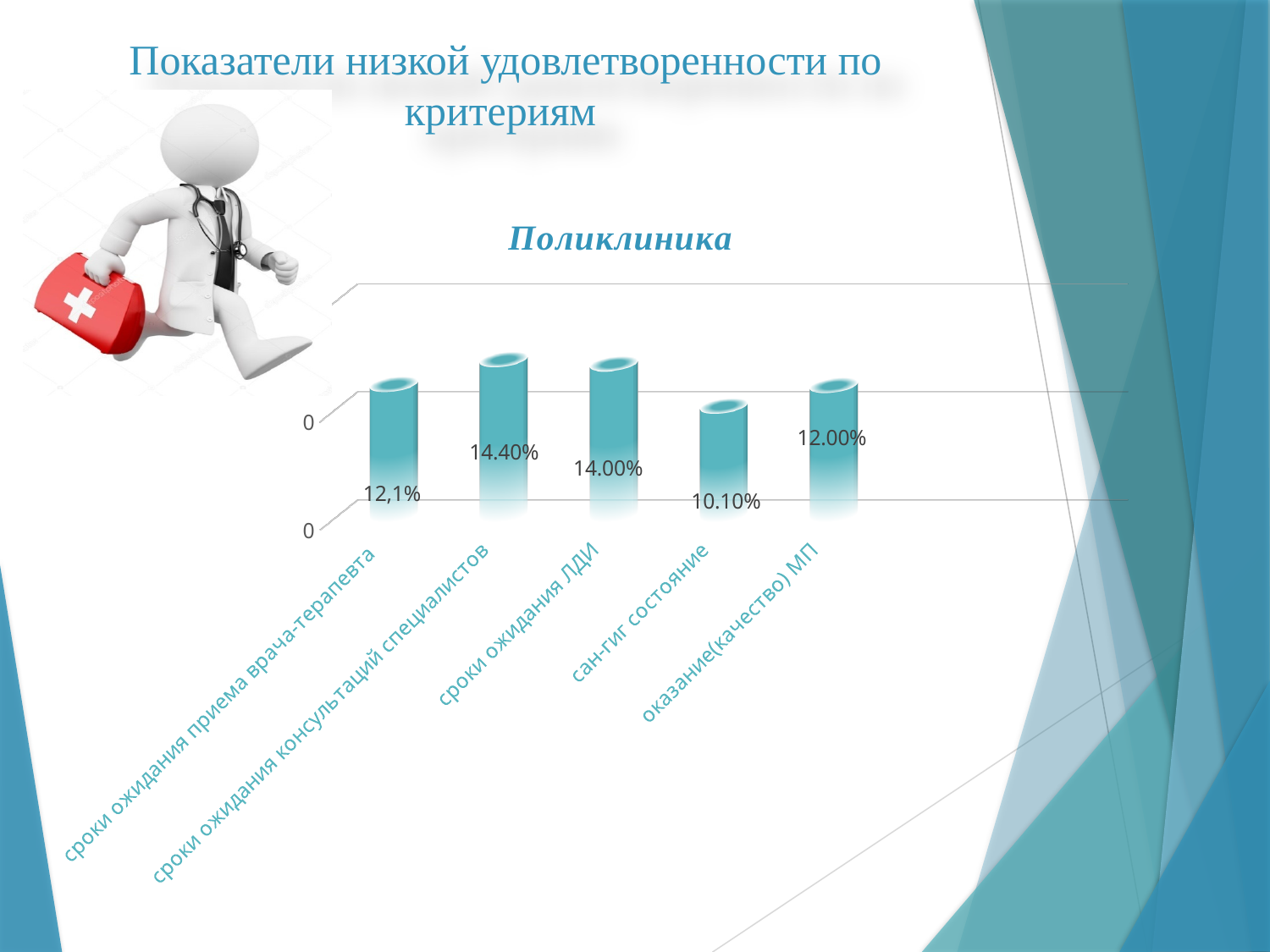
What is the value for сроки ожидания ЛДИ? 14.00% What is the value for сроки ожидания приема врача-терапевта? 12,1% What is the value for сан-гиг состояние? 10.10% Which is larger: the value for сроки ожидания ЛДИ or the value for оказание(качество) МП? сроки ожидания ЛДИ What kind of chart is shown on the slide? bar chart Which category has the highest value? сроки ожидания консультаций специалистов What is the value for оказание(качество) МП? 12.00% What is the title of the chart? Поликлиника What is the value for сроки ожидания консультаций специалистов? 14.40% How many categories are shown in the chart? 5 What is the difference between the values for сроки ожидания консультаций специалистов and сан-гиг состояние? 4.30% Which category has the lowest value? сан-гиг состояние